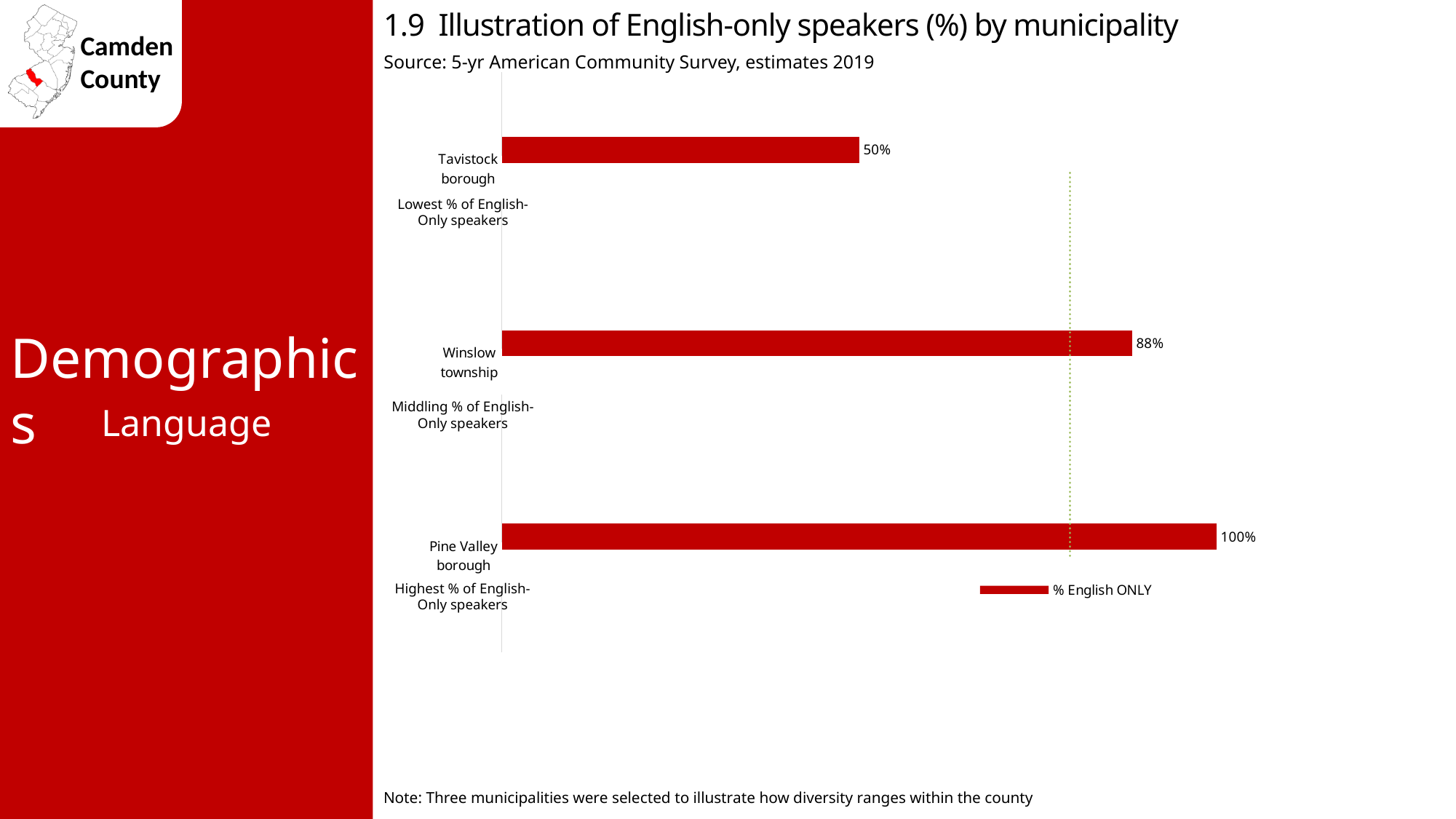
What is the legend entry for the series in the chart? % English ONLY How many municipalities are shown in the chart? 3 What is the value for Winslow township? 88% Which municipality has the lowest percentage of English-only speakers? Tavistock borough Which municipality has the highest percentage of English-only speakers? Pine Valley borough How many series does the legend list? 1 What is the value for Pine Valley borough? 100% What kind of chart is shown on the slide? Bar chart What is the difference between the values for Pine Valley borough and Tavistock borough? 50% Which is larger, the value for Winslow township or the value for Tavistock borough? Winslow township What is the difference between the values for Winslow township and Tavistock borough? 38% What is the value for Tavistock borough? 50%